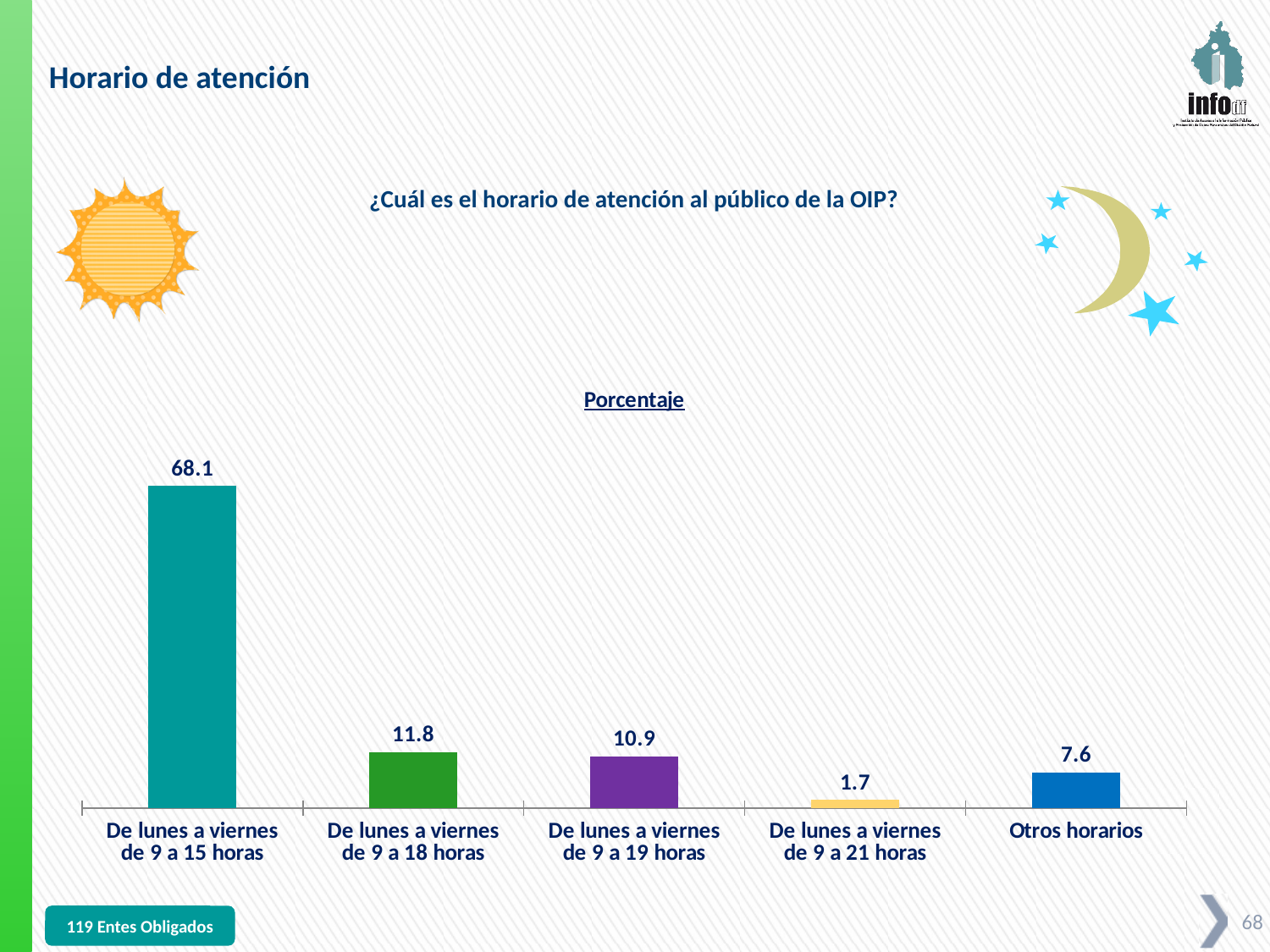
What is the value for 'De lunes a viernes de 9 a 19 horas'? 10.9 What kind of chart is shown on the slide? Bar chart What is the difference between the values for 'De lunes a viernes de 9 a 15 horas' and 'De lunes a viernes de 9 a 18 horas'? 56.3 Which category has the highest value? De lunes a viernes de 9 a 15 horas What is the value for 'Otros horarios'? 7.6 What is the value for 'De lunes a viernes de 9 a 15 horas'? 68.1 What is the value for 'De lunes a viernes de 9 a 21 horas'? 1.7 What is the value for 'De lunes a viernes de 9 a 18 horas'? 11.8 Which is larger, the value for 'Otros horarios' or the value for 'De lunes a viernes de 9 a 21 horas'? Otros horarios What is the title of the chart? Porcentaje How many categories are shown in the chart? 5 Which category has the lowest value? De lunes a viernes de 9 a 21 horas